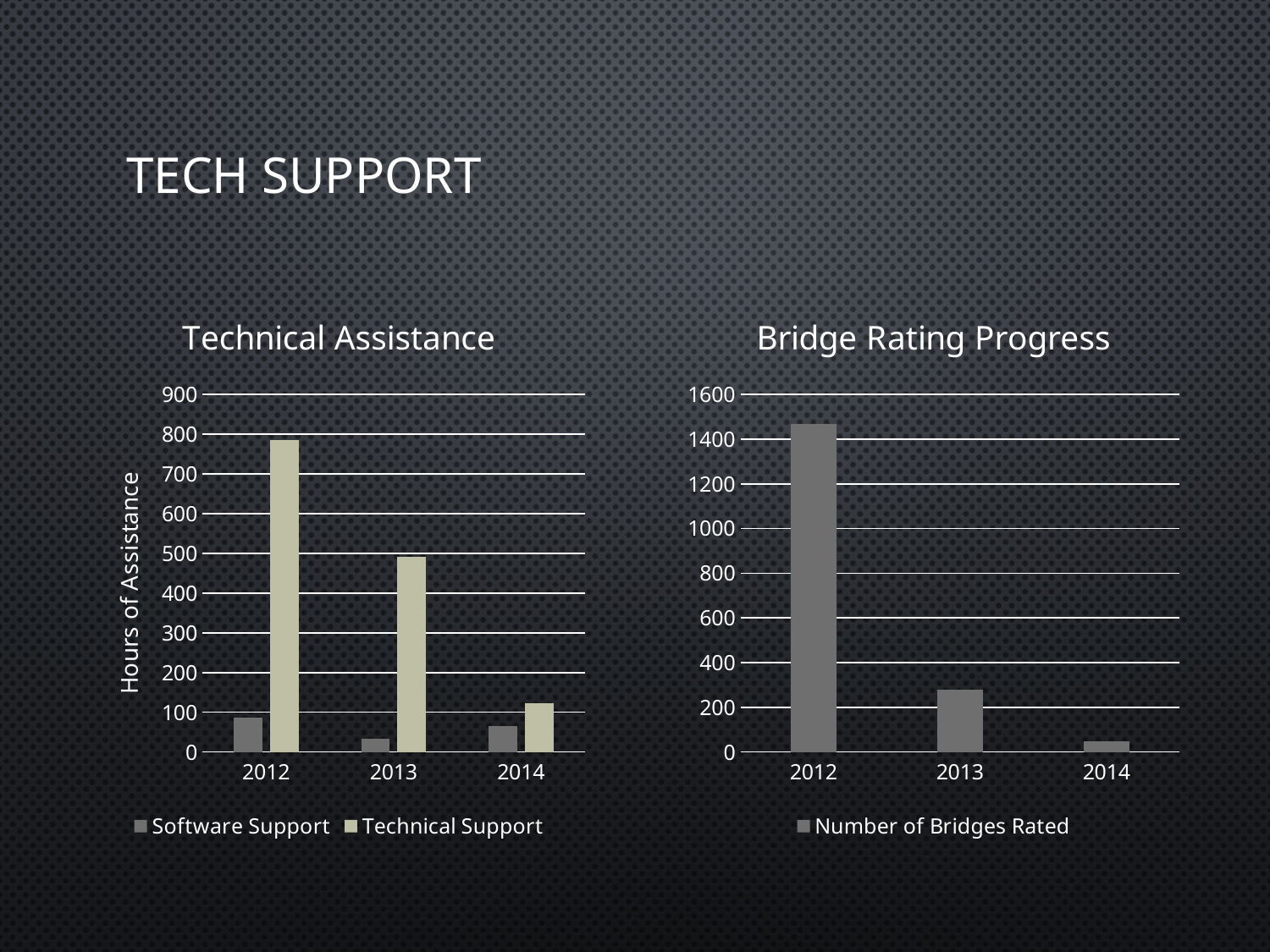
In the Bridge Rating Progress chart, which year has the highest number of bridges rated? 2012 How many series does the legend of the Technical Assistance chart list? 2 In the Technical Assistance chart, is the Technical Support value for 2012 greater or less than 700? greater In the Bridge Rating Progress chart, do the values rise or fall from 2012 to 2014? fall In the Technical Assistance chart, which year has the lowest Software Support value? 2013 What is the y-axis title of the Technical Assistance chart? Hours of Assistance In the Bridge Rating Progress chart, is the value for 2012 greater or less than 1400? greater In the Technical Assistance chart, is the Technical Support value for 2014 greater or less than 200? less In the Technical Assistance chart, which is larger in 2013: Software Support or Technical Support? Technical Support What kind of chart is the Bridge Rating Progress chart? bar chart In the Technical Assistance chart, which year has the highest Technical Support value? 2012